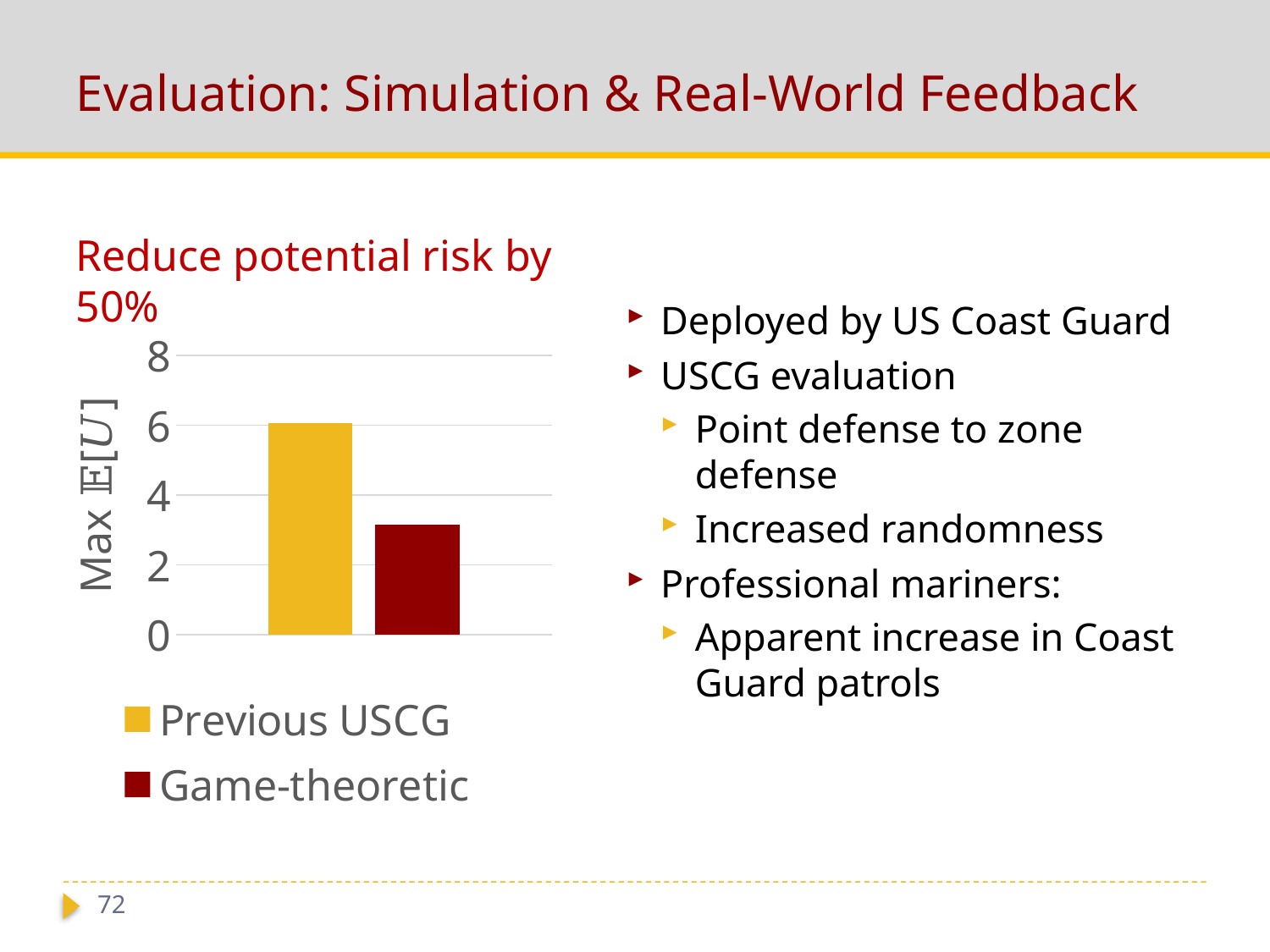
How many bars are plotted in the chart? 2 Is the value for Previous USCG greater or less than 8? less Which series has the highest value in the chart? Previous USCG Which series has the lowest value in the chart? Game-theoretic What kind of chart is shown on the slide? bar chart Which series has the higher bar, Previous USCG or Game-theoretic? Previous USCG Is the value for Game-theoretic greater or less than 4? less What colour is the bar for the Game-theoretic series? dark red How many series does the chart legend list? 2 What is the title of the chart? Reduce potential risk by 50% Is the value for Game-theoretic greater or less than 2? greater